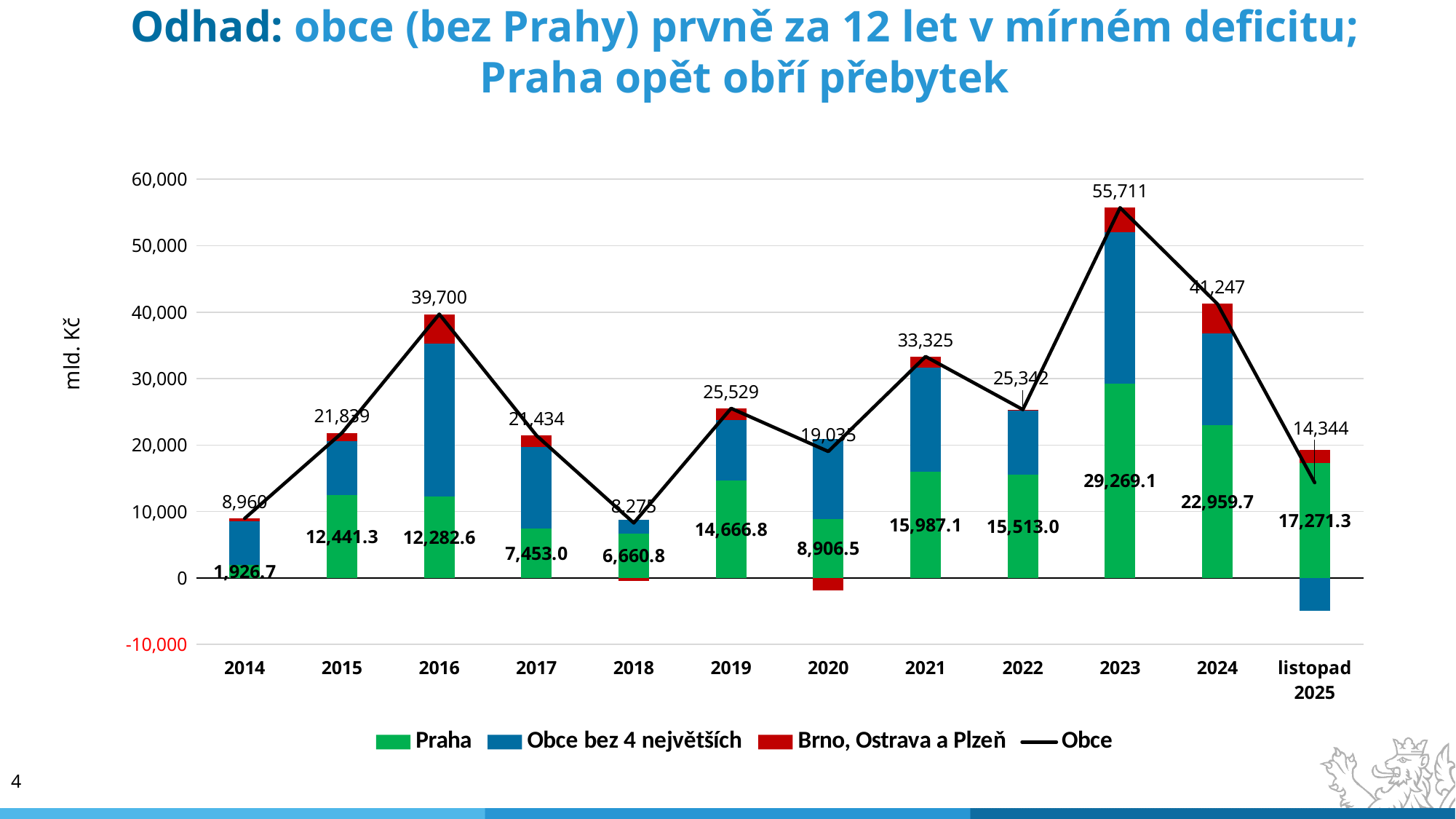
What unit is shown on the y axis? mld. Kč What kind of chart is shown on the slide? Combined stacked bar and line chart Which year has the larger Obce value, 2021 or 2022? 2021 In which year does the Obce line reach its highest value? 2023 Is the value for Obce bez 4 největších in listopad 2025 greater or less than 0? less What is the difference between the Praha values in 2023 and 2024? 6,309.4 What is the value of the Obce line in 2016? 39,700 How many series does the legend list? 4 What is the difference between the Obce values in 2023 and 2021? 22,386 What is the value for Praha in 2023? 29,269.1 In which year is the Praha value the lowest? 2014 How many time periods are shown on the x axis? 12